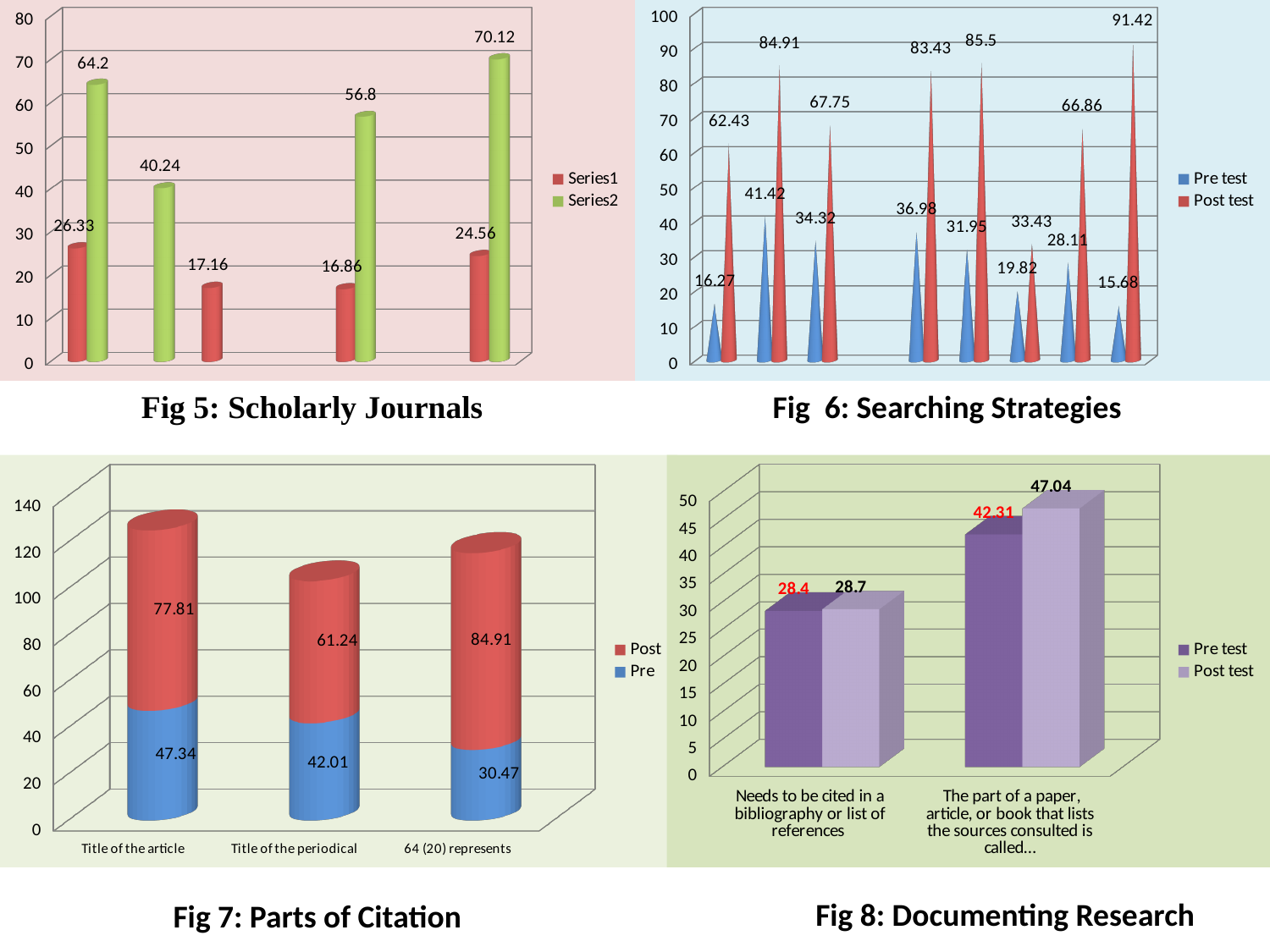
In Fig 6: Searching Strategies, what is the lowest Pre test value? 15.68 In Fig 7: Parts of Citation, what is the total of the stacked bar for Title of the periodical? 103.25 In Fig 7: Parts of Citation, what is the Post value for 64 (20) represents? 84.91 In Fig 6: Searching Strategies, how many series does the legend list? 2 What kind of chart is Fig 5: Scholarly Journals? Bar chart In Fig 5: Scholarly Journals, what is the highest Series2 value? 70.12 In Fig 8: Documenting Research, what is the Post test value for 'The part of a paper, article, or book that lists the sources consulted is called…'? 47.04 In Fig 7: Parts of Citation, what is the Pre value for Title of the article? 47.34 In Fig 6: Searching Strategies, what is the highest Post test value? 91.42 In Fig 7: Parts of Citation, how many categories are shown on the x axis? 3 In Fig 8: Documenting Research, what is the difference between the Post test and Pre test values for 'The part of a paper, article, or book that lists the sources consulted is called…'? 4.73 In Fig 8: Documenting Research, which series does the legend list first? Pre test